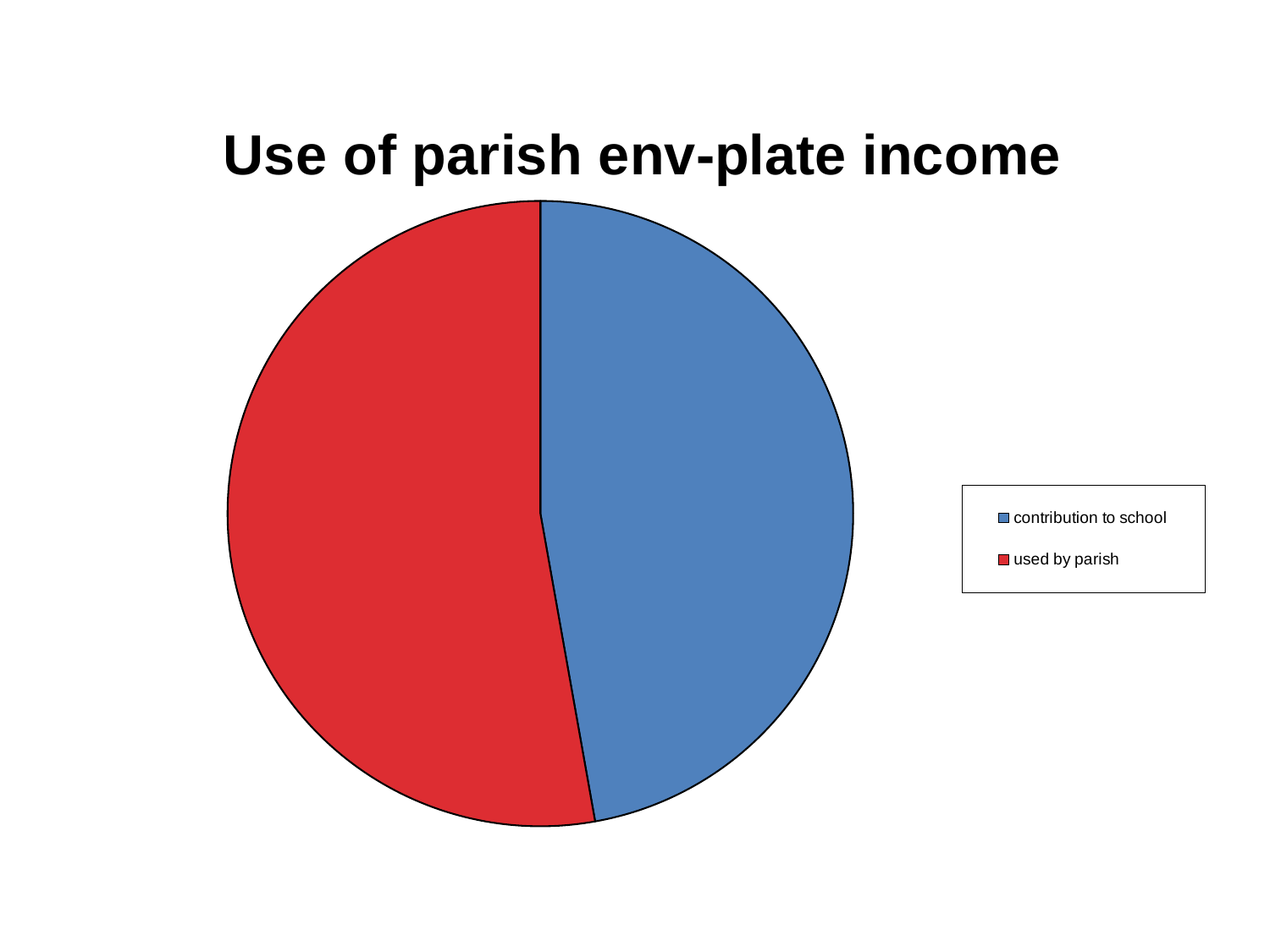
Which category takes up the larger share of the pie? used by parish What kind of chart is shown on the slide? pie chart Which is larger: the slice for "used by parish" or the slice for "contribution to school"? used by parish How many entries does the legend list? 2 How many slices does the pie chart have? 2 Which colour represents "used by parish" in the pie chart? red What is the title of the chart? Use of parish env-plate income Which category takes up the smaller share of the pie? contribution to school